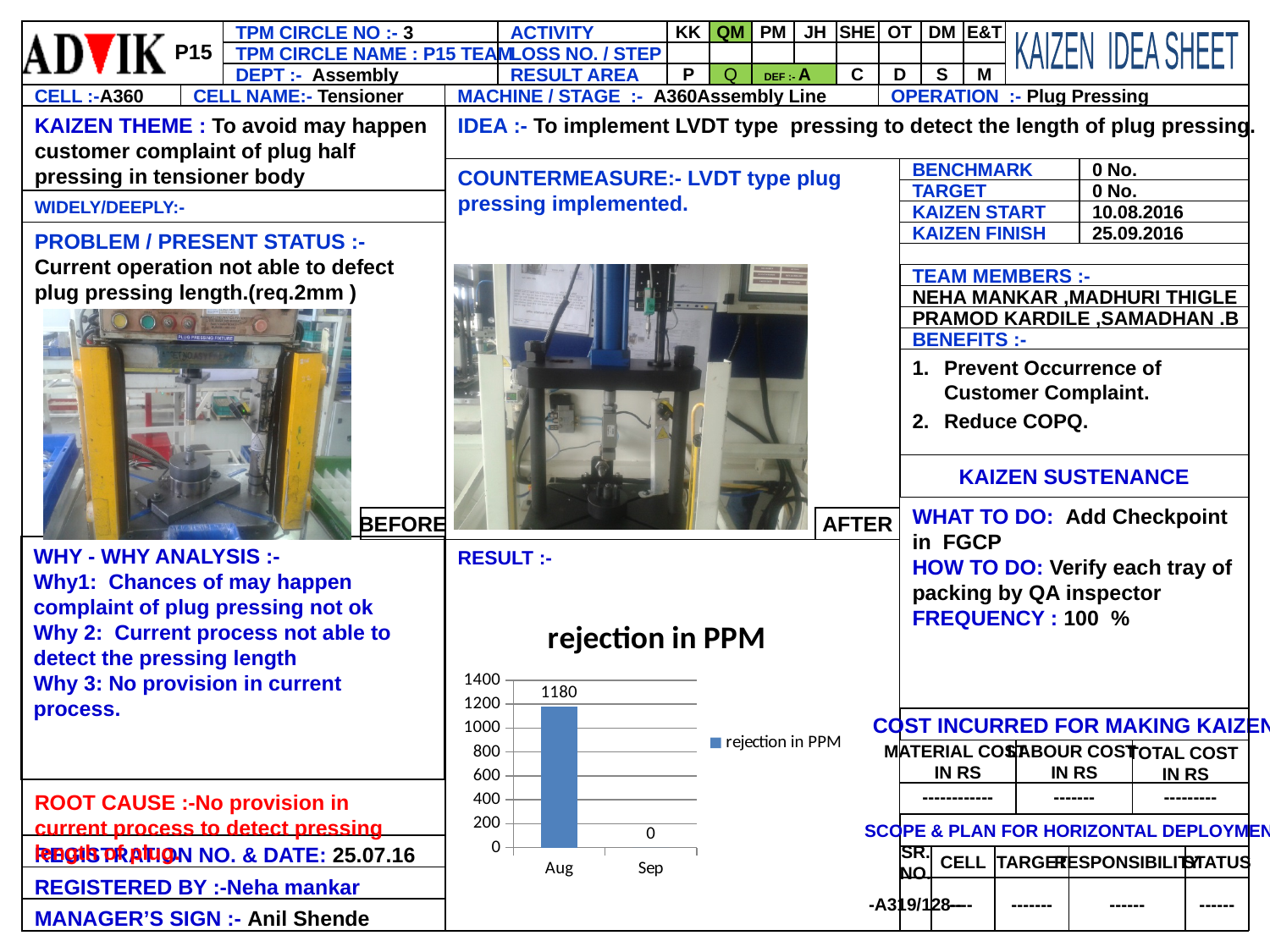
What is the rejection in PPM value for Aug? 1180 How many months are shown on the x axis of the chart? 2 Which is larger, the rejection in PPM for Aug or for Sep? Aug Which month has the highest rejection in PPM? Aug Is the rejection in PPM value for Aug greater or less than 1000? greater How many series does the chart legend list? 1 What is the title of the chart on the slide? rejection in PPM Do the rejection in PPM values rise or fall from Aug to Sep? fall What is the rejection in PPM value for Sep? 0 Which month has the lowest rejection in PPM? Sep What type of chart is shown on the slide? bar chart What is the difference in rejection in PPM between Aug and Sep? 1180